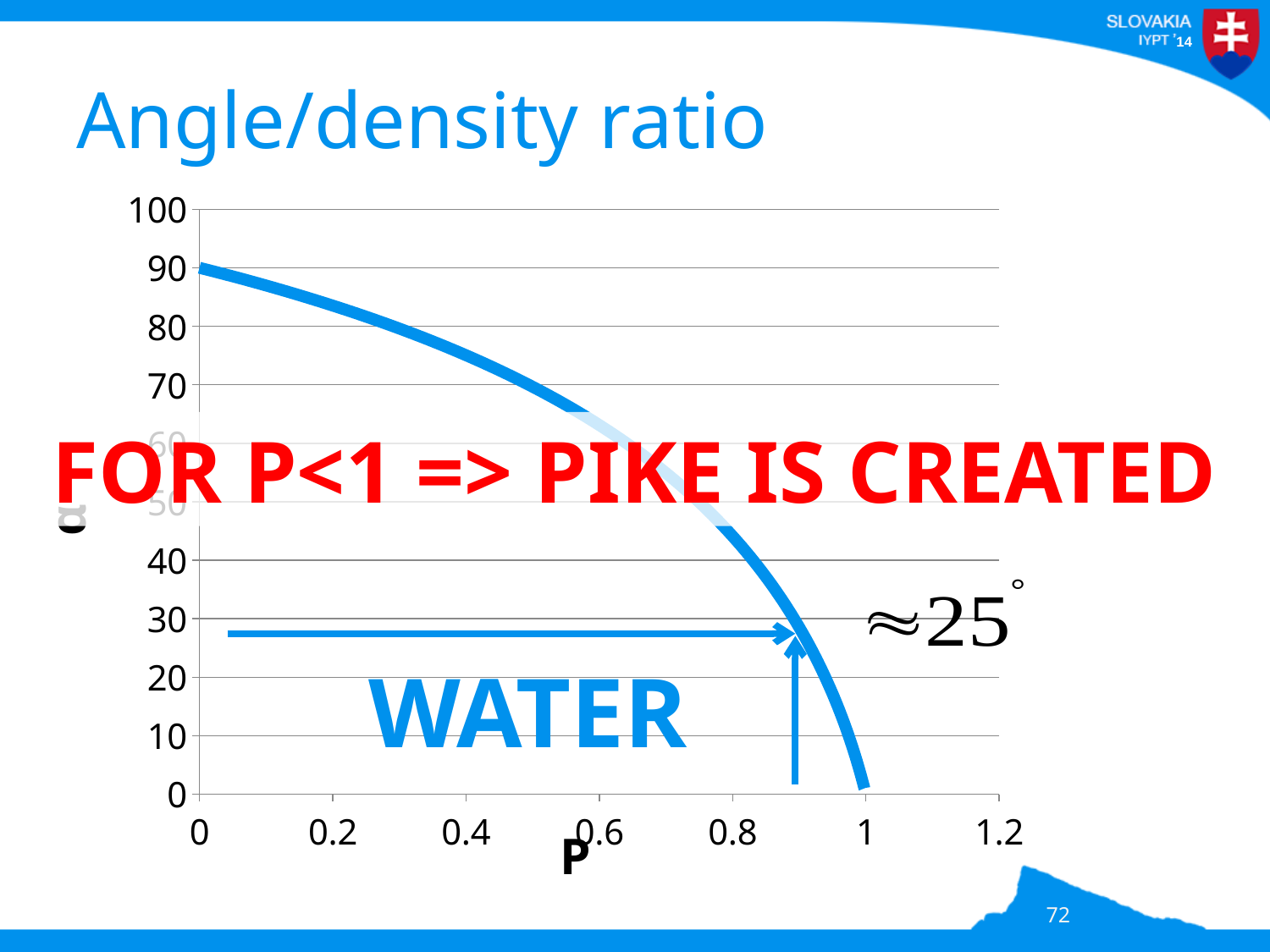
Does the value of α rise or fall as P increases? fall What is the label of the x axis? P Is the value of α at P = 0.6 greater or less than 50? greater Is the value of α at P = 0.2 greater or less than 80? greater Which has the larger value of α: P = 0.2 or P = 0.8? P = 0.2 Is the value of α at P = 0.8 greater or less than 60? less At which value of P does the curve reach its highest α? 0 What is the value of α at P = 1? 0 What kind of chart is shown on the slide? line chart At which value of P does the curve reach its lowest α? 1 What is the value of α at P = 0? 90 What is the title of the chart? Angle/density ratio